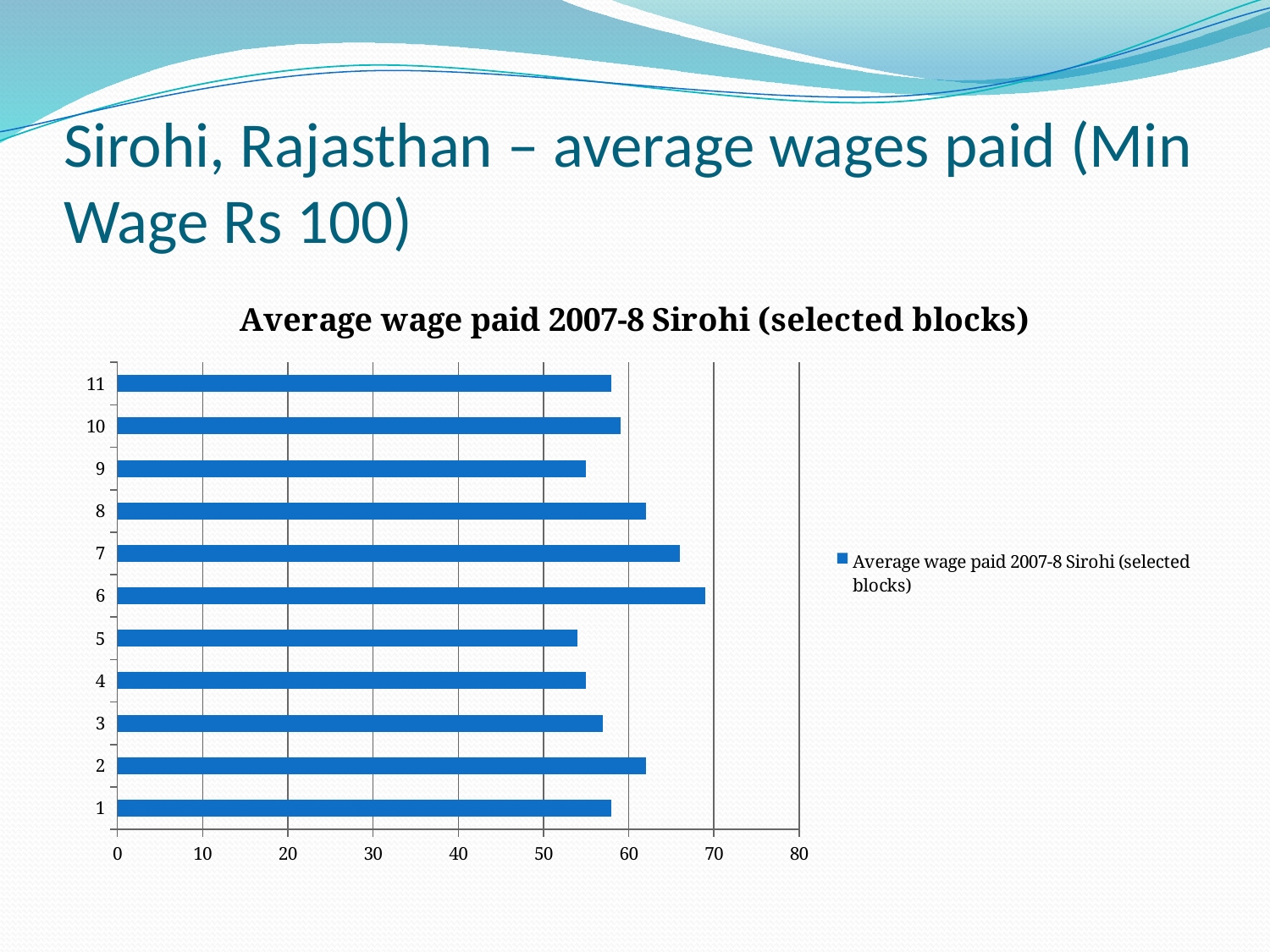
Is the value for category 4 greater or less than 50? greater Is the value for category 9 greater or less than 60? less Is the value for category 6 greater or less than 60? greater How many categories (blocks) are plotted in the chart? 11 Which has the larger value, category 6 or category 5? 6 How many series does the legend list? 1 What is the title of the chart? Average wage paid 2007-8 Sirohi (selected blocks) Which has the larger value, category 7 or category 3? 7 Which category has the highest average wage paid? 6 What kind of chart is shown on the slide? bar chart